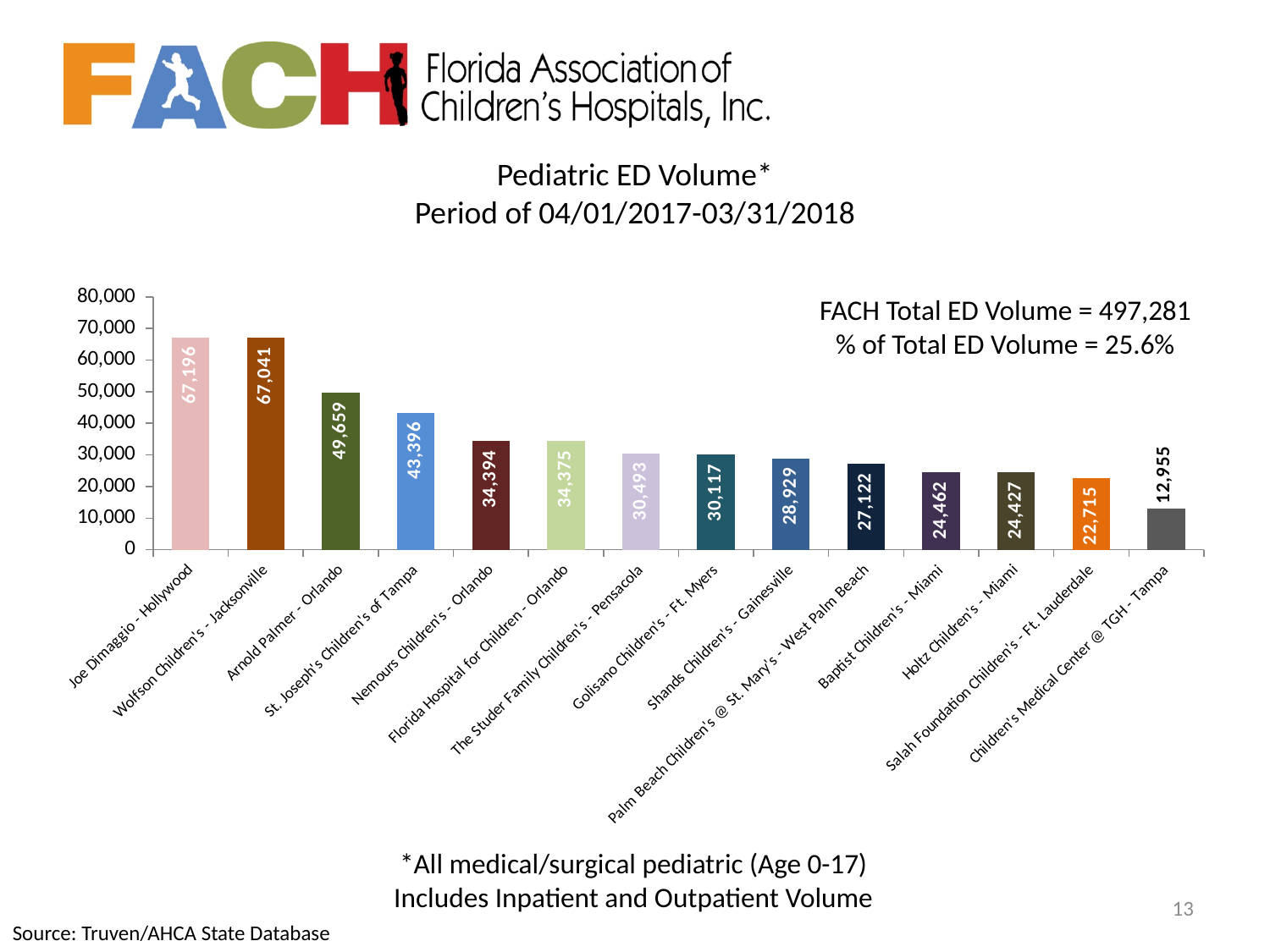
Is the pediatric ED volume for Nemours Children's - Orlando greater or less than 30,000? greater How many hospitals are shown in the chart? 14 What is the pediatric ED volume for Arnold Palmer - Orlando? 49,659 What is the pediatric ED volume for Shands Children's - Gainesville? 28,929 What is the difference in pediatric ED volume between Arnold Palmer - Orlando and St. Joseph's Children's of Tampa? 6,263 Which hospital has the highest pediatric ED volume? Joe Dimaggio - Hollywood Which has a larger pediatric ED volume, Arnold Palmer - Orlando or St. Joseph's Children's of Tampa? Arnold Palmer - Orlando What kind of chart is used to show pediatric ED volume? bar chart What is the difference in pediatric ED volume between Joe Dimaggio - Hollywood and Children's Medical Center @ TGH - Tampa? 54,241 What is the pediatric ED volume for Salah Foundation Children's - Ft. Lauderdale? 22,715 What is the FACH Total ED Volume stated on the chart? 497,281 Which hospital has the lowest pediatric ED volume? Children's Medical Center @ TGH - Tampa